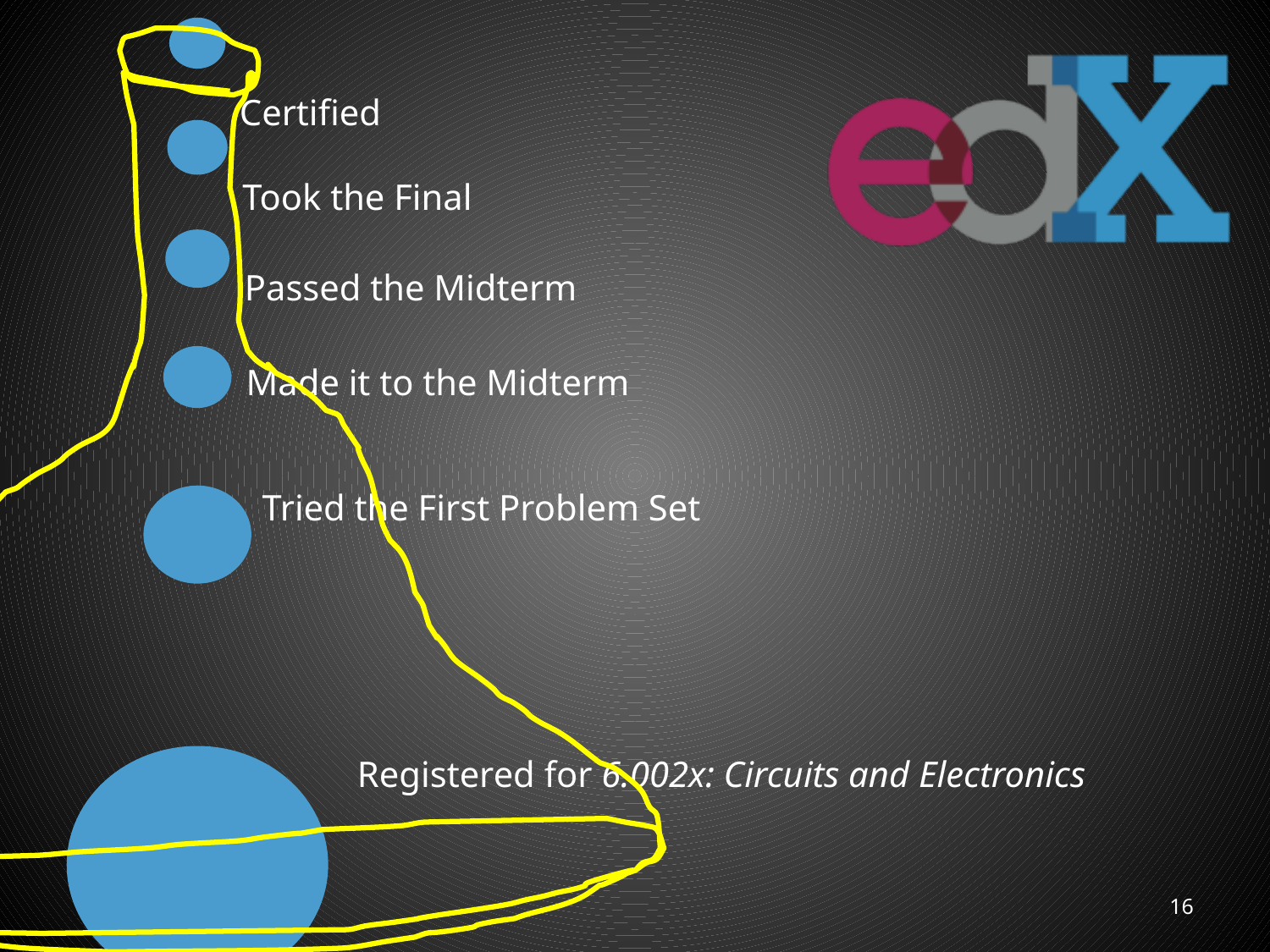
Which stage is represented by the largest circle? Registered for 6.002x: Circuits and Electronics What is the label of the stage at the bottom of the funnel? Registered for 6.002x: Circuits and Electronics Do the circle sizes increase or decrease going from the bottom stage to the top stage? decrease What colour are the circles representing the stages? blue Which circle is larger, the one for 'Registered for 6.002x' or the one for 'Tried the First Problem Set'? Registered for 6.002x Which stage comes directly above 'Passed the Midterm'? Took the Final Which circle is larger, the one for 'Tried the First Problem Set' or the one for 'Made it to the Midterm'? Tried the First Problem Set What shape is outlined in yellow around the circles? a flask (funnel) Which stage is represented by the smallest circle? Certified How many stages are shown as circles on the slide? 6 What is the label of the stage at the top of the funnel? Certified